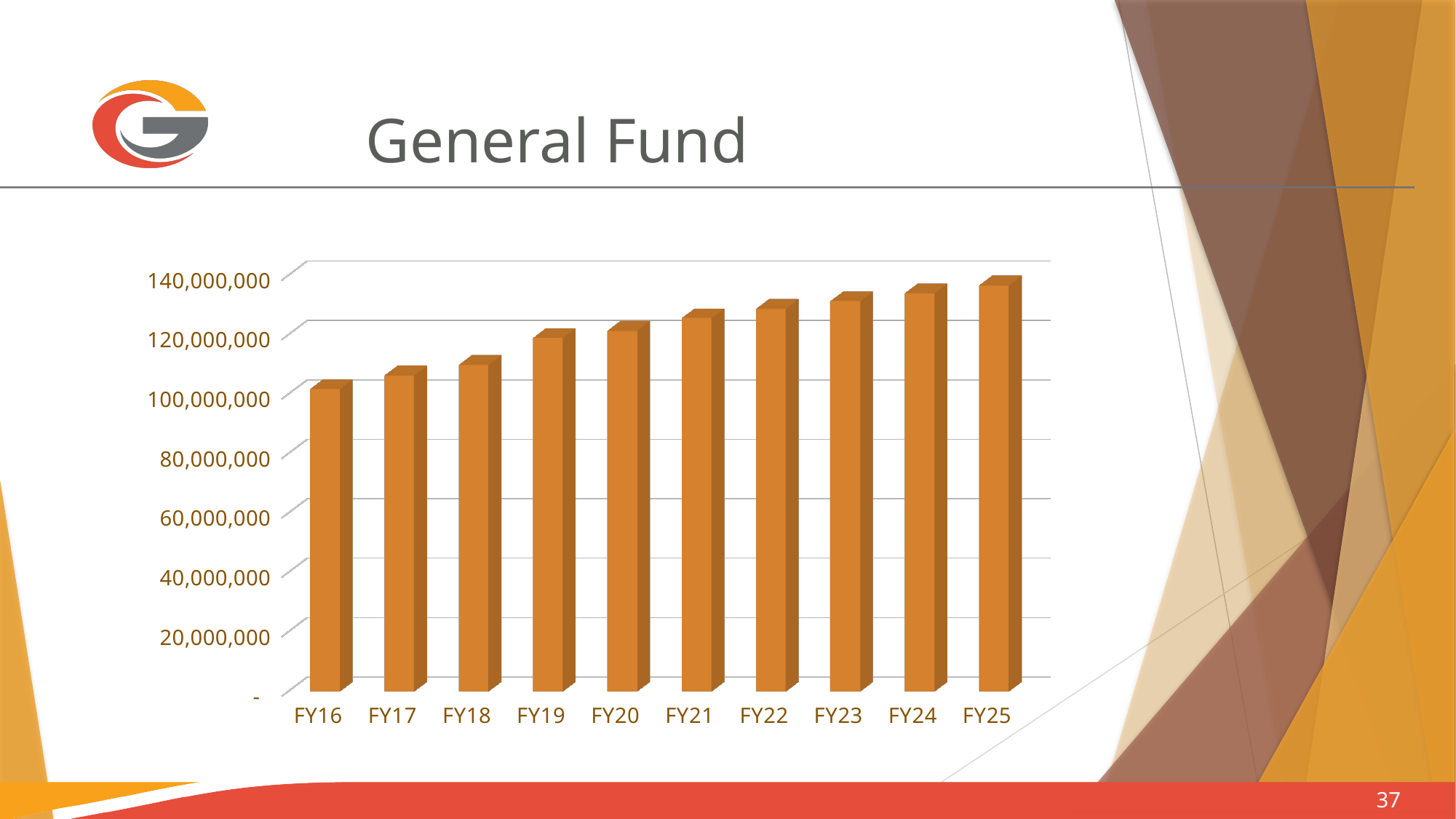
Do the values rise or fall from FY16 to FY25? rise Is the value for FY25 greater or less than 140,000,000? less Which is larger, the value for FY18 or the value for FY23? FY23 Is the value for FY16 greater or less than 80,000,000? greater Which is larger, the value for FY25 or the value for FY16? FY25 Is the value for FY18 greater or less than 120,000,000? less How many fiscal years are plotted on the chart? 10 Which fiscal year has the highest value? FY25 What is the title of the slide containing the chart? General Fund Which fiscal year has the lowest value? FY16 What kind of chart is shown on the slide? bar chart